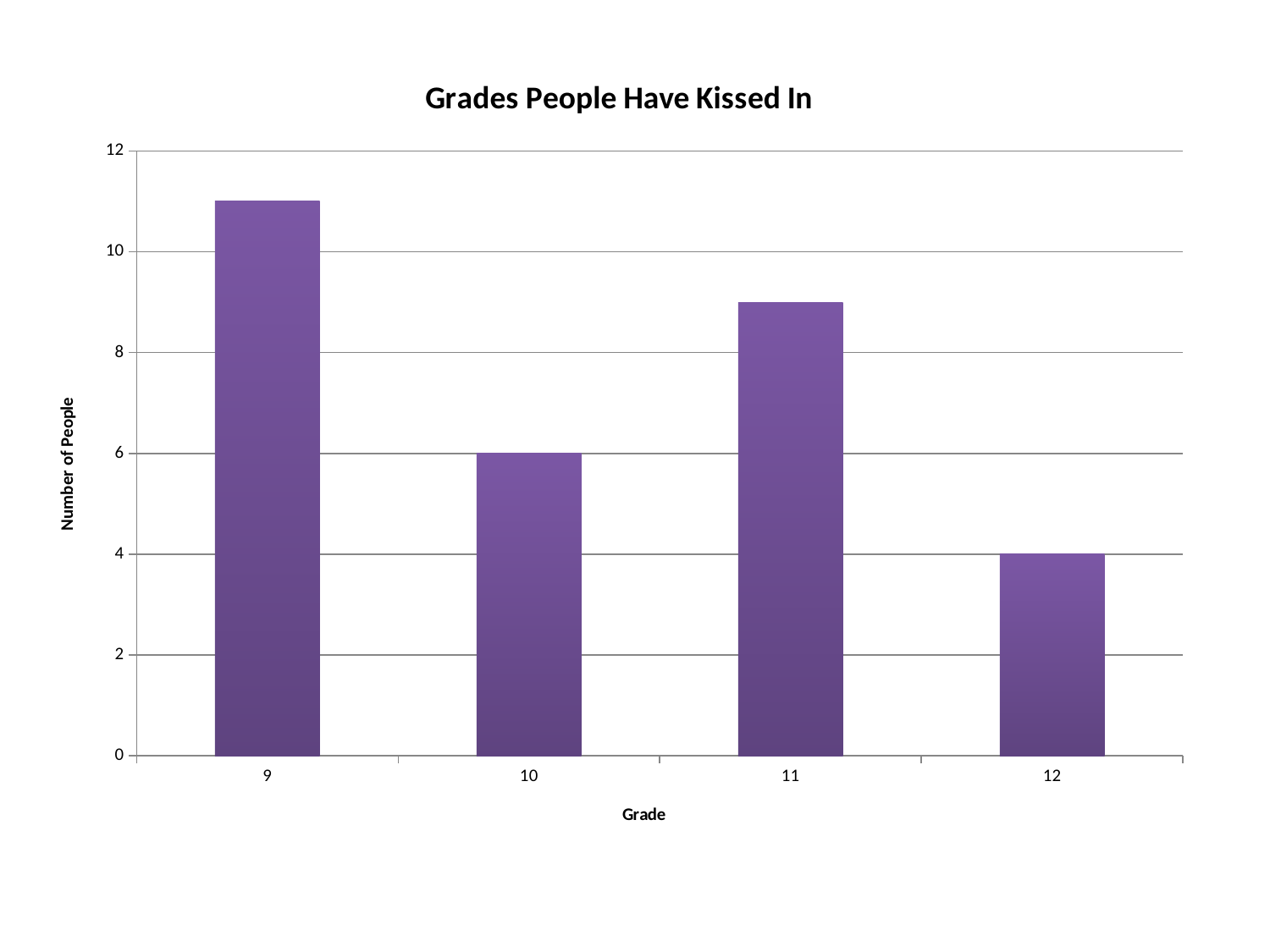
What kind of chart is this? bar chart Is the value for grade 9 greater or less than 10? greater What is the number of people for grade 10? 6 Which grade has the lowest number of people? 12 How many grades are shown on the x axis? 4 Is the value for grade 11 greater or less than 8? greater Which grade has the highest number of people? 9 Which has more people, grade 10 or grade 11? 11 What is the title of the chart? Grades People Have Kissed In What is the difference in number of people between grade 10 and grade 12? 2 What is the number of people for grade 12? 4 What is the label of the y axis? Number of People